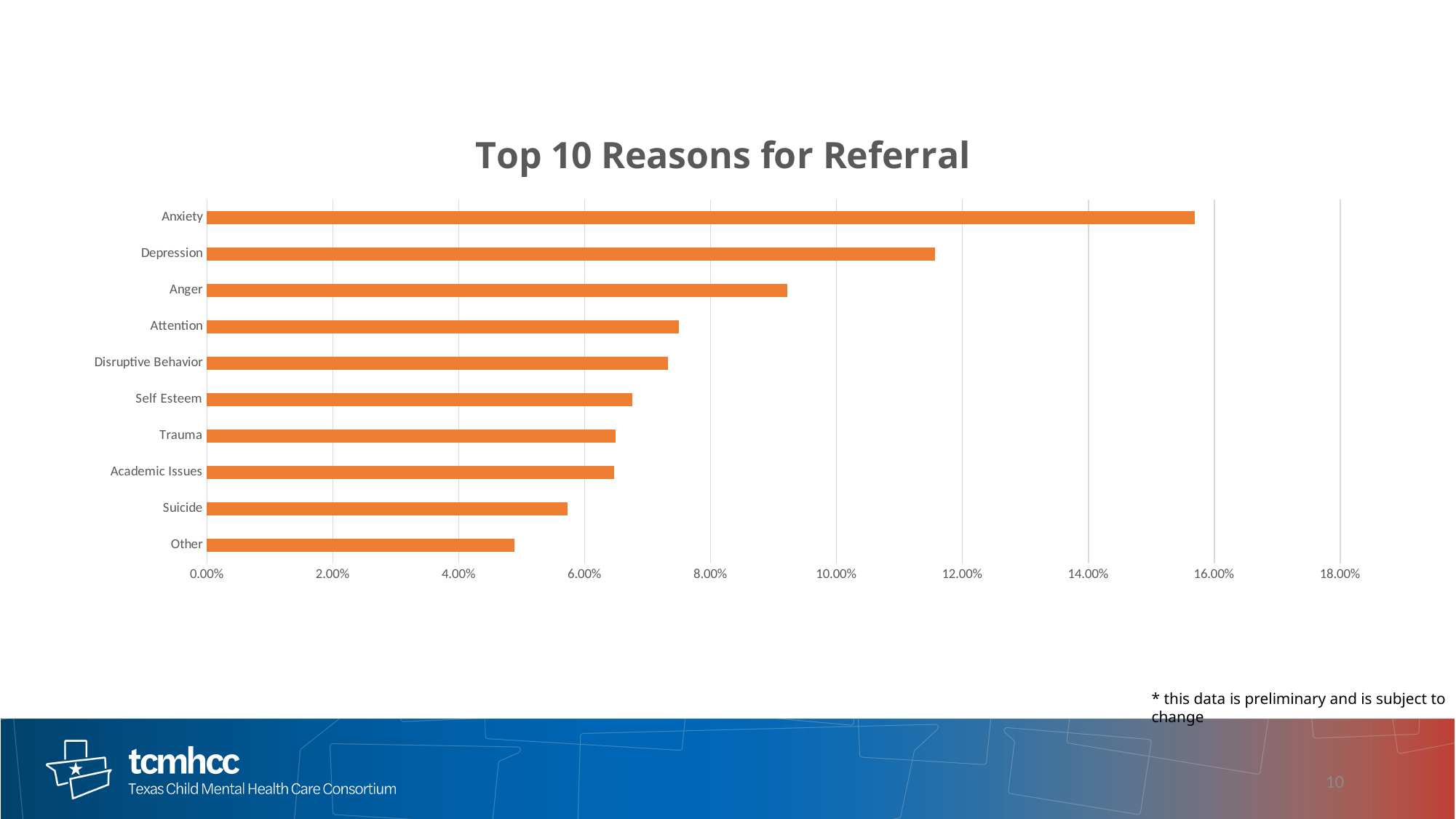
Which referral reason has the highest percentage? Anxiety Is the value for Other greater or less than 6.00%? less Is the value for Anger greater or less than 8.00%? greater Which referral reason has the lowest percentage? Other Do the bar values increase or decrease going from the top category (Anxiety) to the bottom category (Other)? Decrease Which has a larger value, Anxiety or Depression? Anxiety What is the title of the chart? Top 10 Reasons for Referral Is the value for Anxiety greater or less than 14.00%? greater Which has a larger value, Suicide or Other? Suicide How many referral reasons are plotted in the chart? 10 What kind of chart is shown on the slide? Bar chart